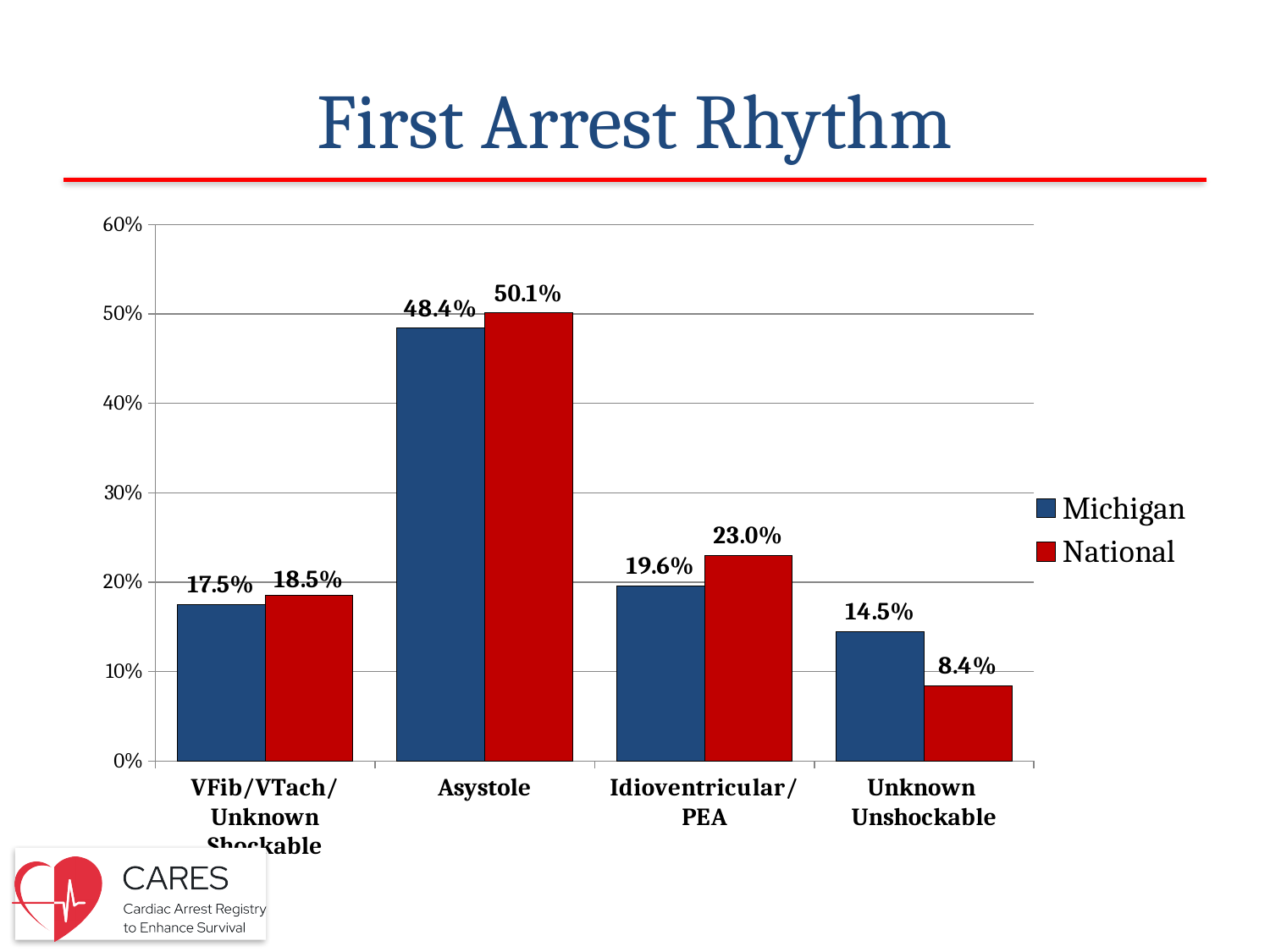
What is the National value for Idioventricular/PEA? 23.0% What is the Michigan value for Asystole? 48.4% What is the National value for Unknown Unshockable? 8.4% What is the difference between the National and Michigan values for Idioventricular/PEA? 3.4% For Unknown Unshockable, which is larger: the Michigan value or the National value? Michigan Which category has the highest National value? Asystole Is the Michigan value for Asystole greater or less than 40%? greater How many categories are shown on the x axis? 4 Which category has the lowest Michigan value? Unknown Unshockable What kind of chart is shown on the slide? bar chart What is the difference between the Michigan and National values for Unknown Unshockable? 6.1% How many series does the legend list? 2